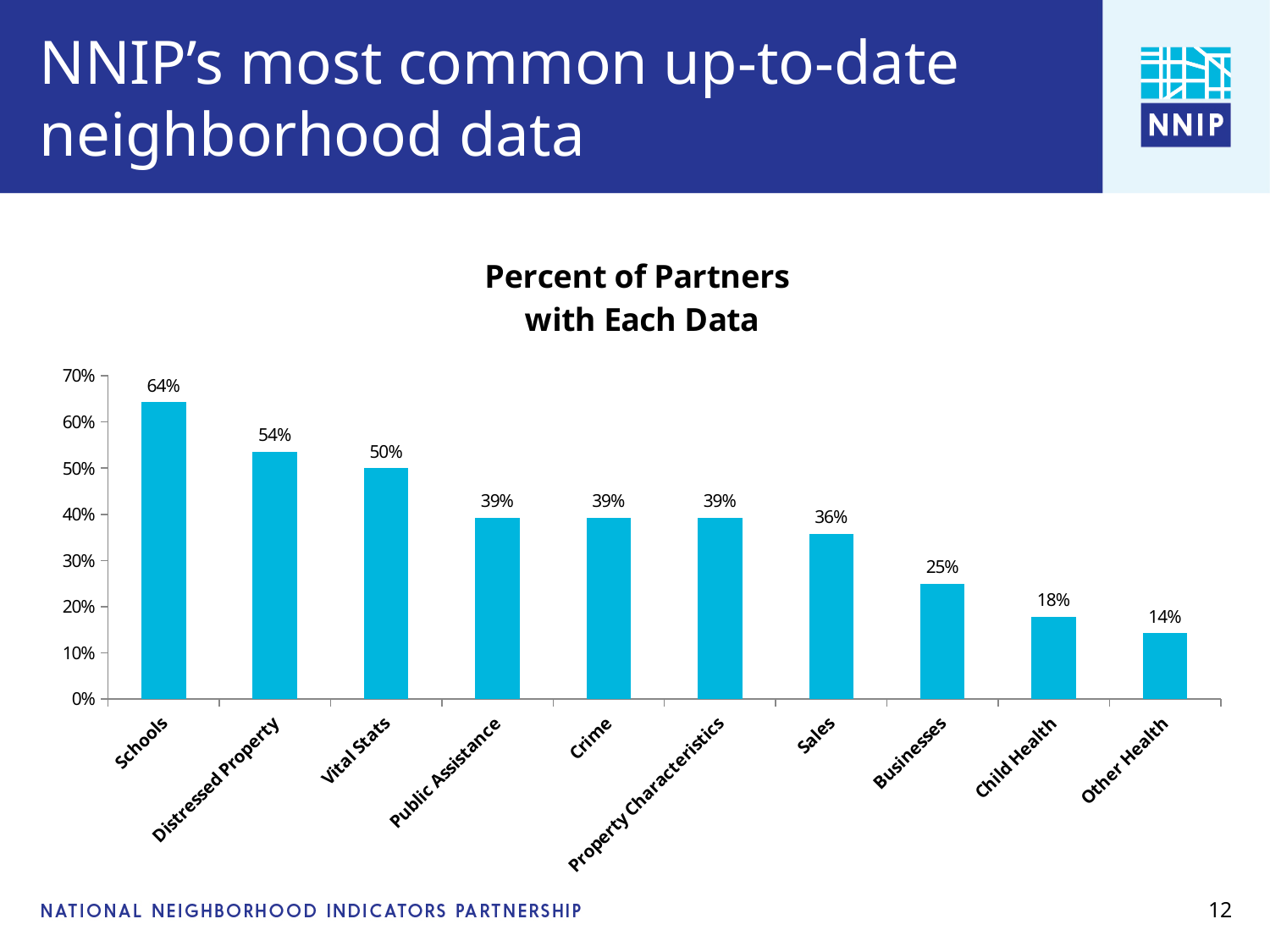
Which is larger, the value for Vital Stats or the value for Sales? Vital Stats Do the values rise or fall moving from left to right along the x axis? Fall Which category has the lowest percent of partners? Other Health How many categories are shown on the x axis? 10 What is the value for Businesses? 25% What kind of chart is shown on the slide? Bar chart What is the difference between the values for Schools and Distressed Property? 10% What percent of partners have Schools data? 64% What is the difference between the values for Sales and Other Health? 22% Which category has the highest percent of partners? Schools What is the title of the chart? Percent of Partners with Each Data What percent of partners have Child Health data? 18%